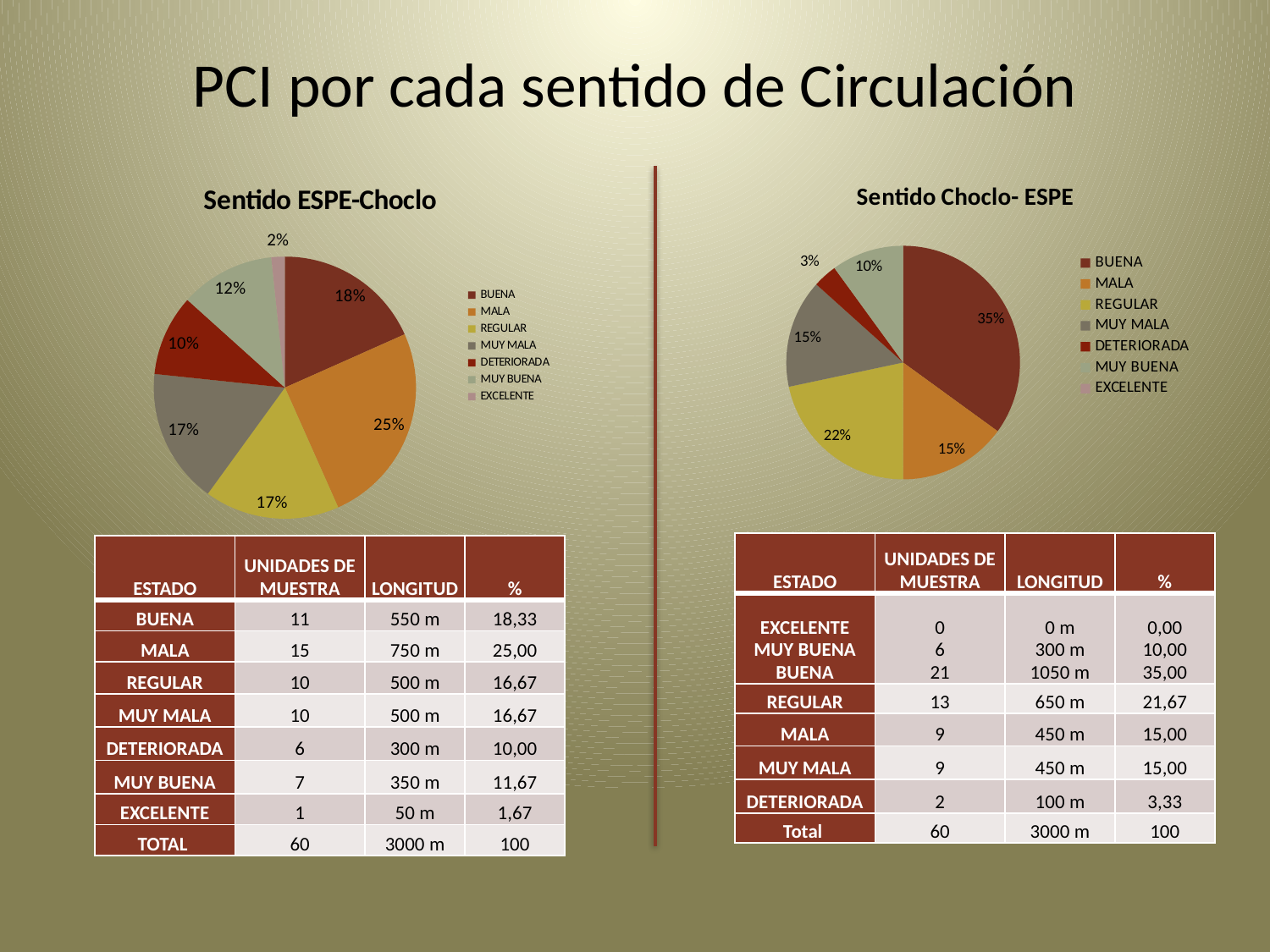
How many entries does the legend of the "Sentido Choclo- ESPE" chart list? 7 In the "Sentido Choclo- ESPE" chart, which is larger, the REGULAR slice or the MUY BUENA slice? REGULAR In the "Sentido ESPE-Choclo" chart, which category has the smallest slice? EXCELENTE In the "Sentido Choclo- ESPE" chart, which category has the largest slice? BUENA In the "Sentido ESPE-Choclo" chart, which category has the largest slice? MALA In the "Sentido ESPE-Choclo" chart, what is the difference between the MALA and DETERIORADA percentages? 15% In the "Sentido ESPE-Choclo" chart, what percentage does the MALA slice show? 25% In the "Sentido Choclo- ESPE" chart, what percentage does the BUENA slice show? 35% In the "Sentido ESPE-Choclo" chart, what percentage does the BUENA slice show? 18% What is the title of the pie chart on the left side of the slide? Sentido ESPE-Choclo What type of chart is "Sentido ESPE-Choclo"? Pie chart In the "Sentido Choclo- ESPE" chart, what percentage does the REGULAR slice show? 22%